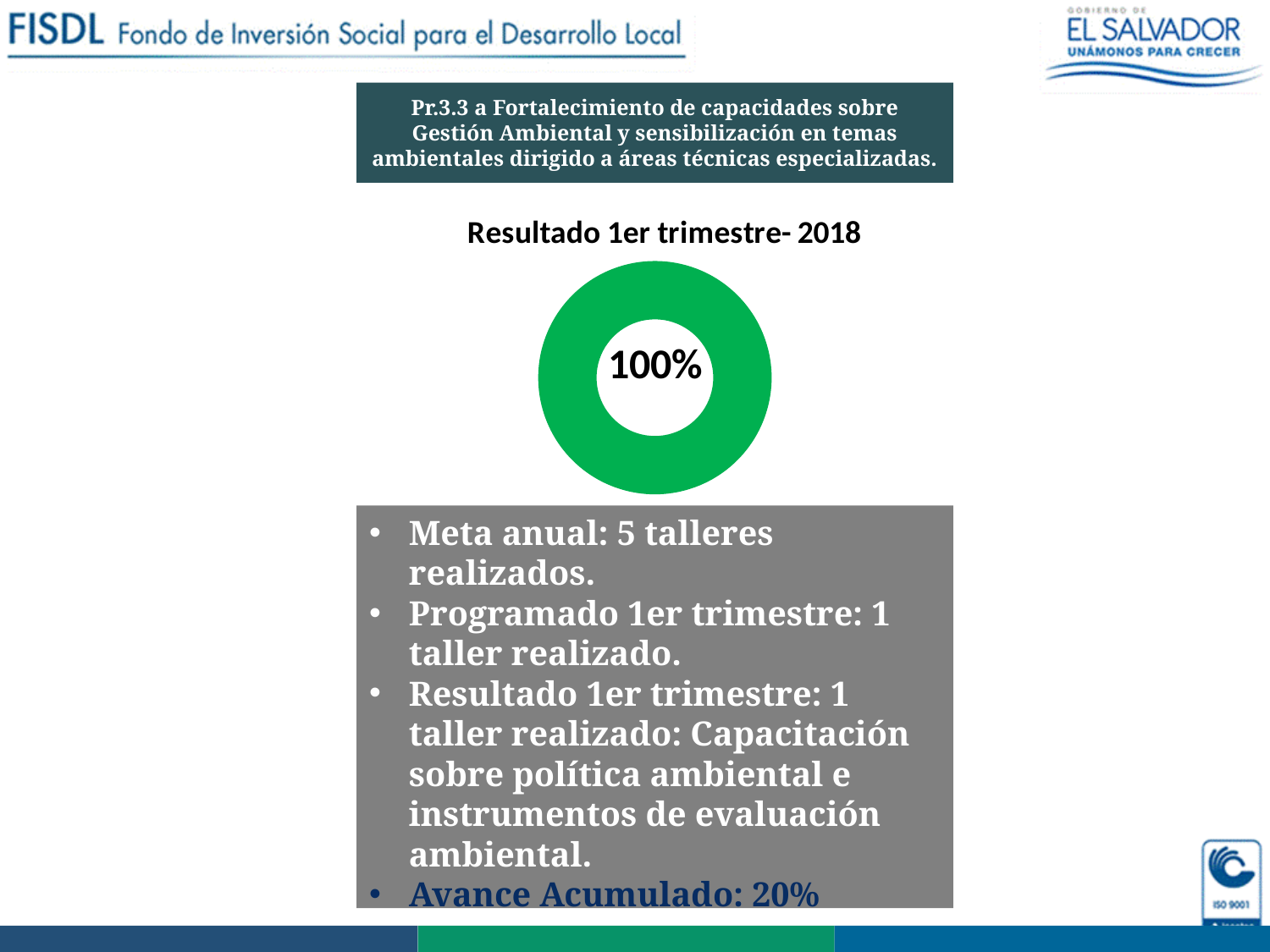
What colour is the ring of the doughnut chart? Green Is the value shown in the doughnut chart greater or less than 50%? greater What share of the doughnut does the green segment represent? 100% How many segments does the doughnut chart show? 1 What value is printed in the centre of the doughnut chart? 100% What is the title of the chart? Resultado 1er trimestre- 2018 What kind of chart is shown on the slide? Doughnut chart